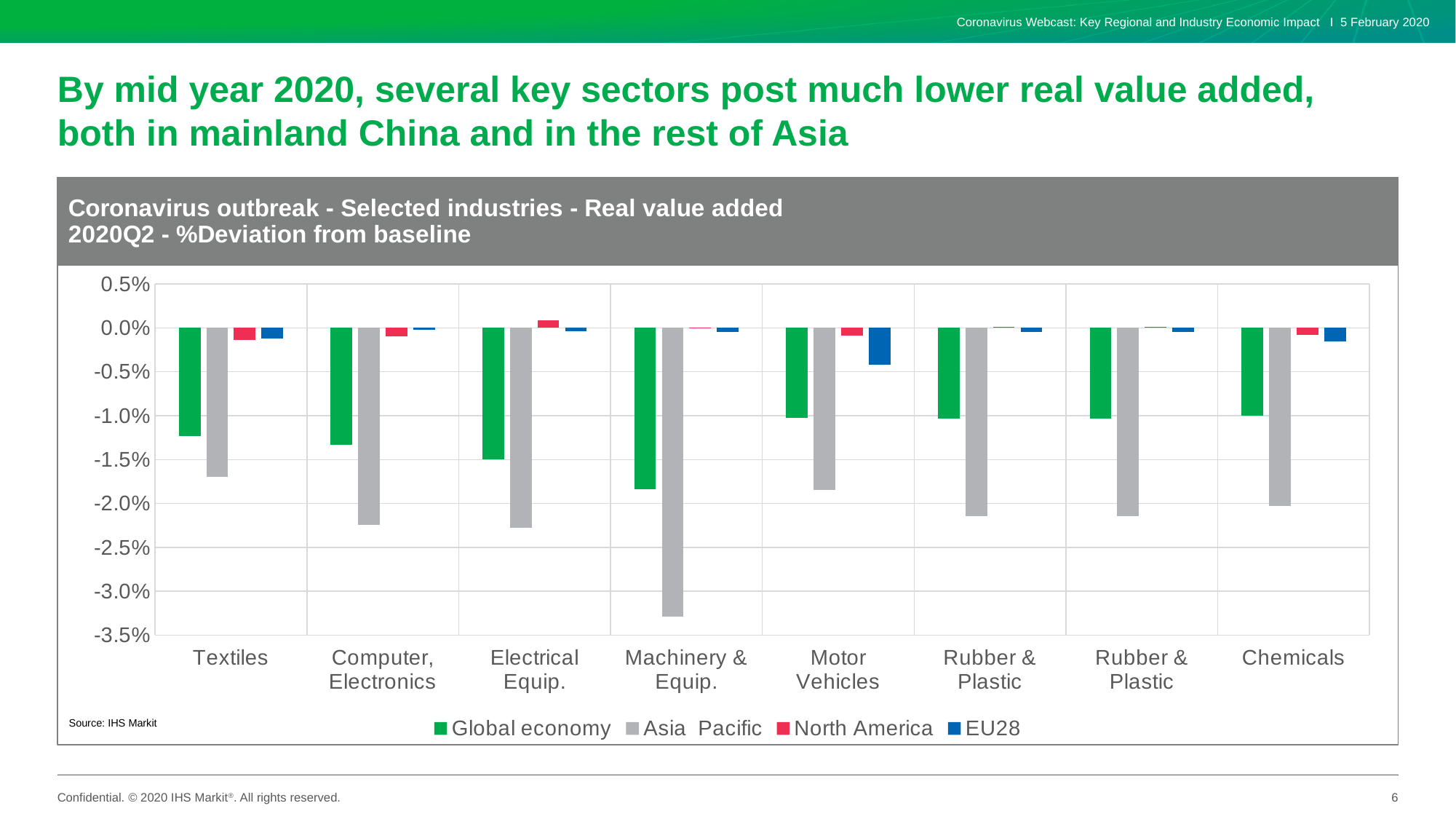
For which industry is the Asia Pacific value the lowest? Machinery & Equip. For which industry is the Global economy value the lowest? Machinery & Equip. How many industry categories are shown on the x axis? 8 For which industry is the EU28 value the lowest? Motor Vehicles Is the Asia Pacific value for Machinery & Equip. greater or less than -3.0%? less What is the title of the chart? Coronavirus outbreak - Selected industries - Real value added 2020Q2 - %Deviation from baseline For Textiles, which is more negative: the Global economy value or the Asia Pacific value? Asia Pacific How many series does the legend list? 4 Is the Asia Pacific value for Textiles greater or less than -1.5%? less For which industry is the North America value the highest? Electrical Equip. What kind of chart is shown on the slide? bar chart Is the EU28 value for Motor Vehicles greater or less than -0.5%? greater